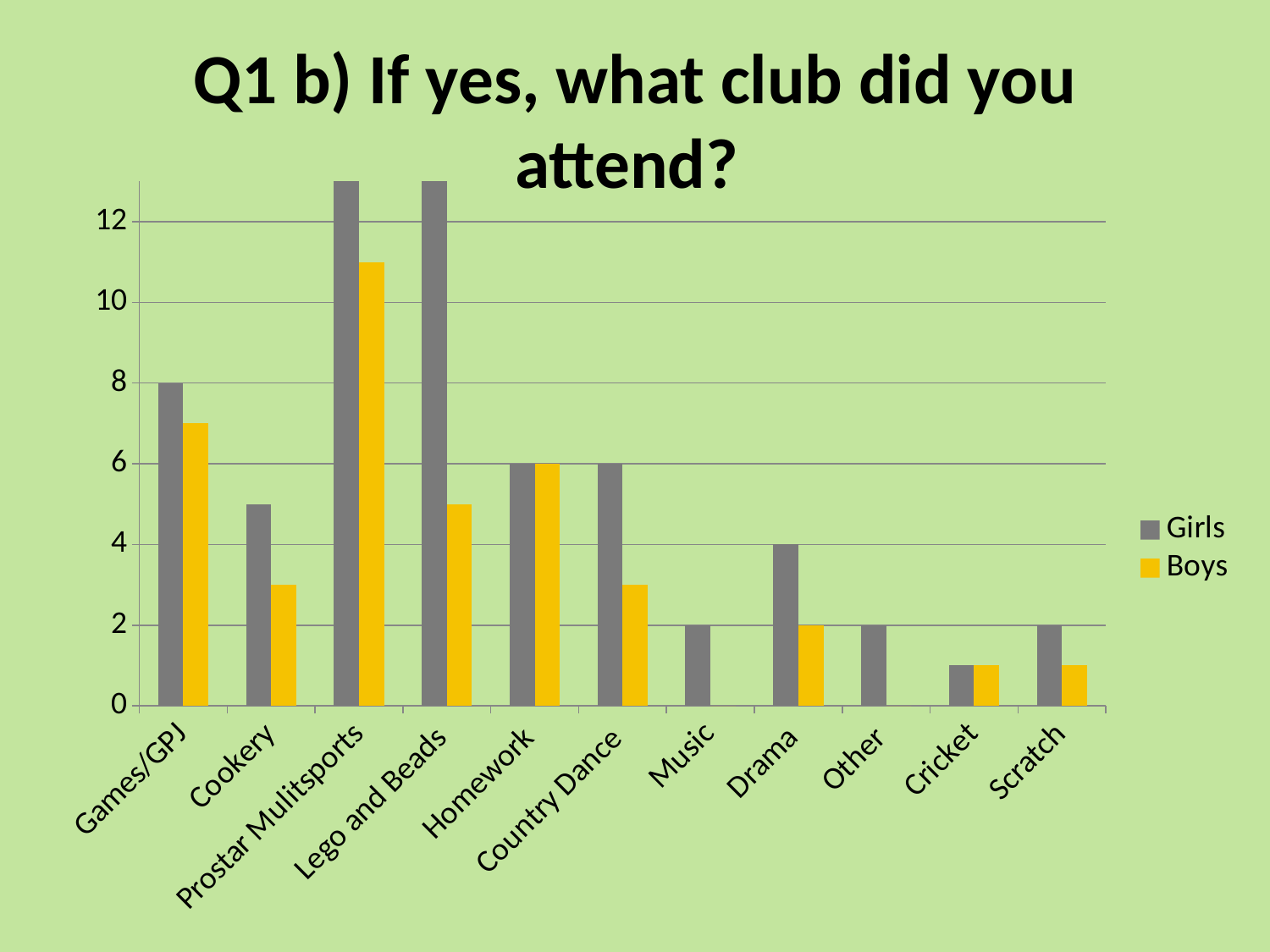
Is the Boys value for Prostar Mulitsports greater or less than 10? greater How many clubs are shown on the x axis? 11 What is the Girls value for Games/GPJ? 8 What is the Boys value for Homework? 6 What is the difference between the Girls and Boys values for Drama? 2 Is the Girls value for Cookery greater or less than 4? greater Which is larger for Lego and Beads, the Girls value or the Boys value? Girls How many series does the legend list? 2 What is the Girls value for Drama? 4 What is the Girls value for Music? 2 What kind of chart is shown on the slide? bar chart Which club has the highest Boys value? Prostar Mulitsports